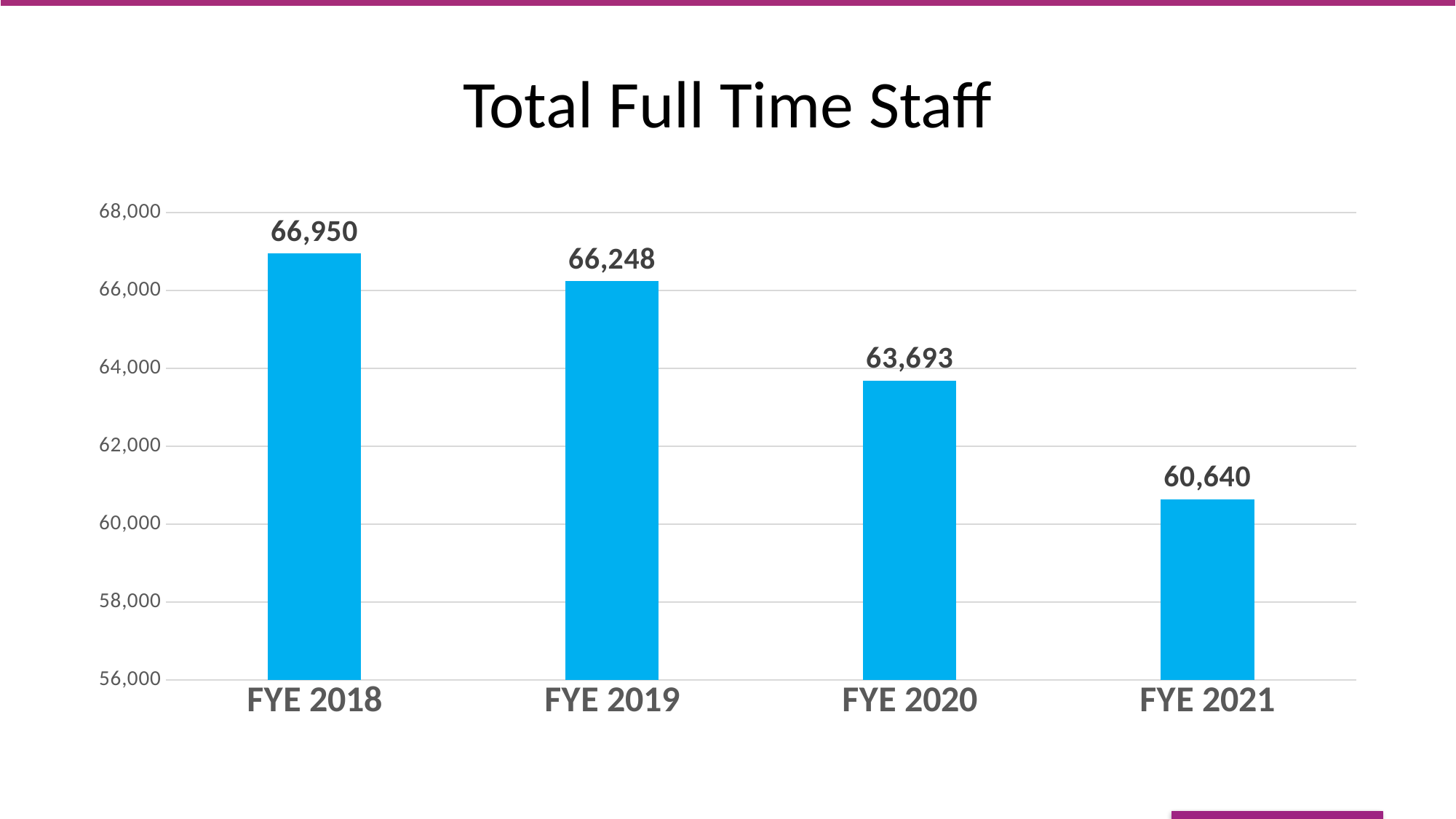
What is the total full time staff for FYE 2018? 66,950 What is the total full time staff for FYE 2020? 63,693 What kind of chart is shown on the slide? Bar chart What is the difference in total full time staff between FYE 2018 and FYE 2021? 6,310 Do the total full time staff values rise or fall from FYE 2018 to FYE 2021? Fall How many fiscal years are shown in the chart? 4 Which fiscal year has the lowest total full time staff? FYE 2021 What is the total full time staff for FYE 2019? 66,248 Which fiscal year has the highest total full time staff? FYE 2018 Which has more full time staff, FYE 2020 or FYE 2021? FYE 2020 What is the difference in total full time staff between FYE 2019 and FYE 2020? 2,555 What is the total full time staff for FYE 2021? 60,640